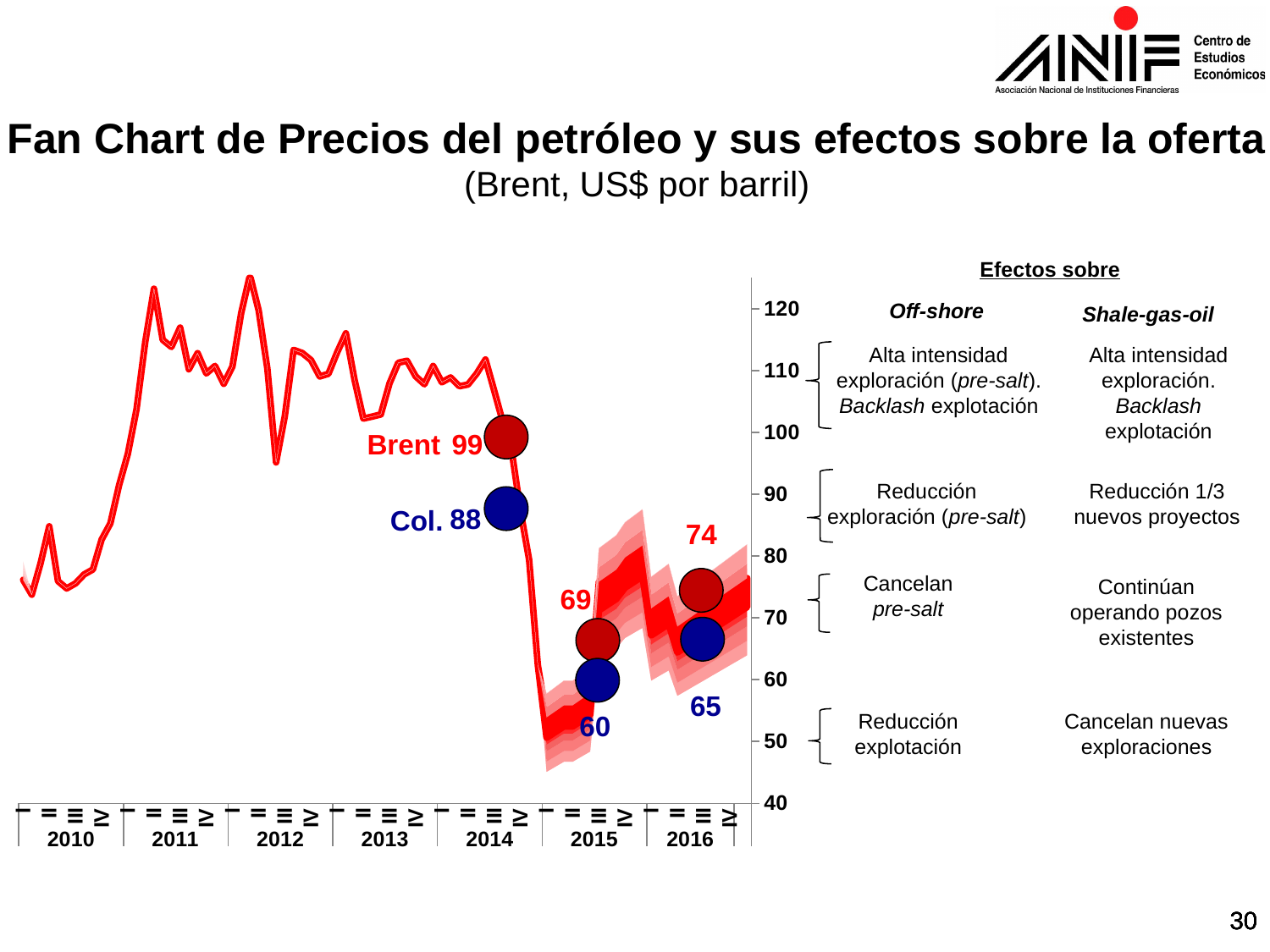
What is the difference between the Brent value (99) and the Col. value (88) labelled for 2014? 11 How many years are labelled on the x axis of the chart? 7 What Brent price is labelled on the chart for 2014? 99 Which is larger: the Brent value labelled for 2015 or the blue value labelled for 2016? Brent 2015 (69) Is the lowest point of the line in early 2015 greater or less than 60? less What value is labelled for Col. in 2014? 88 Does the price line rise or fall between 2014 and early 2015? fall By how much does the labelled Brent value for 2016 exceed the labelled Brent value for 2015? 5 What Brent value is labelled for 2016? 74 What is the lower (blue) labelled value for 2016? 65 What is the lower (blue) labelled value for 2015? 60 What Brent value is labelled for 2015? 69